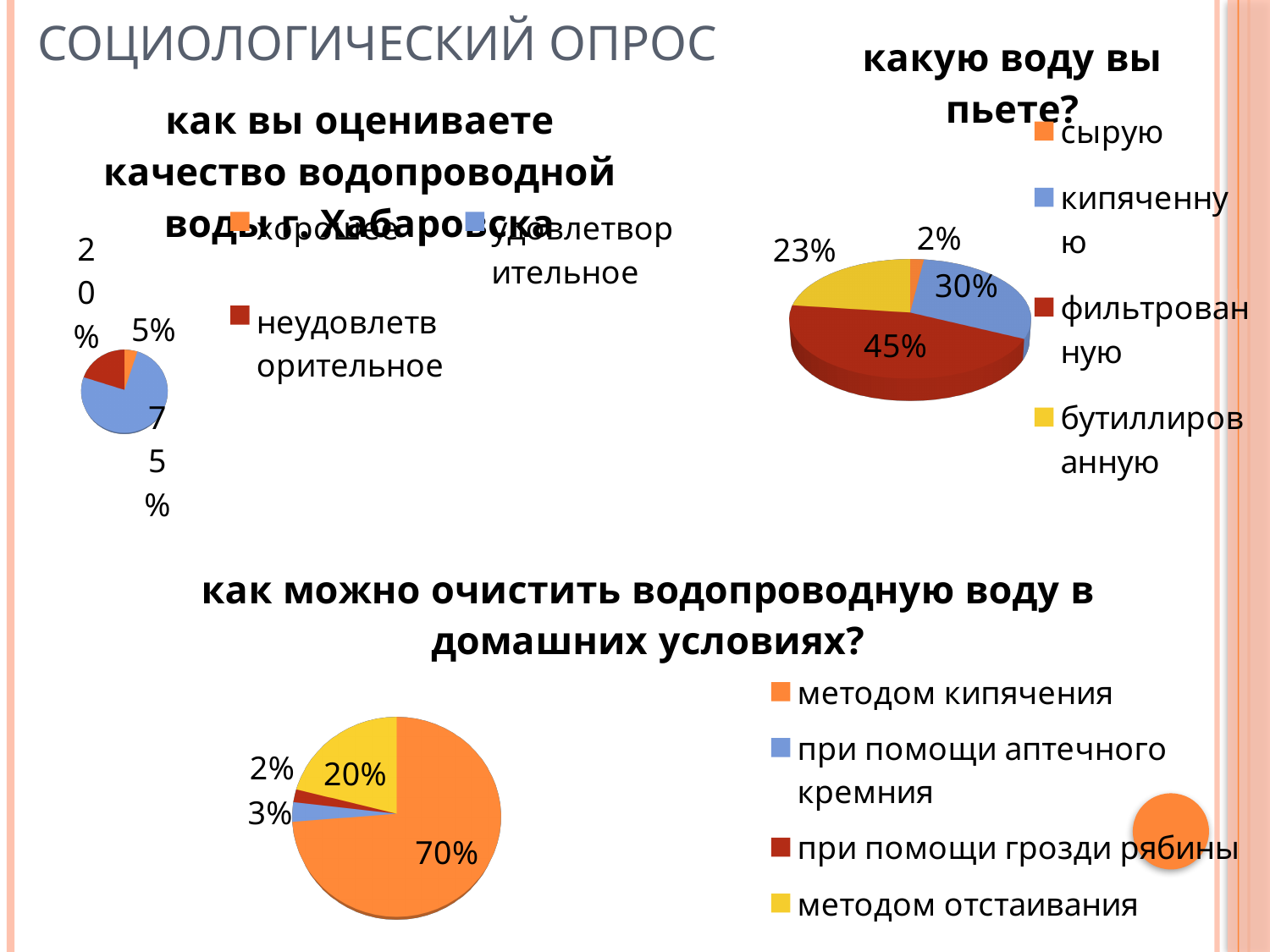
In the chart "какую воду вы пьете?", what share of respondents drink сырую water? 2% In the chart "какую воду вы пьете?", what share of respondents drink фильтрованную water? 45% In the chart "как можно очистить водопроводную воду в домашних условиях?", which is larger: методом отстаивания or при помощи аптечного кремния? методом отстаивания In the chart "какую воду вы пьете?", how many categories does the legend list? 4 In the chart "какую воду вы пьете?", what is the difference between the shares for кипяченную and бутиллированную? 7% In the chart "как можно очистить водопроводную воду в домашних условиях?", what share is for методом кипячения? 70% In the chart "какую воду вы пьете?", which category has the largest share? фильтрованную In the chart "как вы оцениваете качество водопроводной воды в г. Хабаровска", what is the difference between the shares for неудовлетворительное and хорошее? 15% What type of chart is used for "как можно очистить водопроводную воду в домашних условиях?"? pie chart In the chart "как можно очистить водопроводную воду в домашних условиях?", what colour is the slice for методом отстаивания? yellow In the chart "как вы оцениваете качество водопроводной воды в г. Хабаровска", what share of respondents rated the water удовлетворительное? 75% In the chart "как можно очистить водопроводную воду в домашних условиях?", which category has the smallest share? при помощи грозди рябины